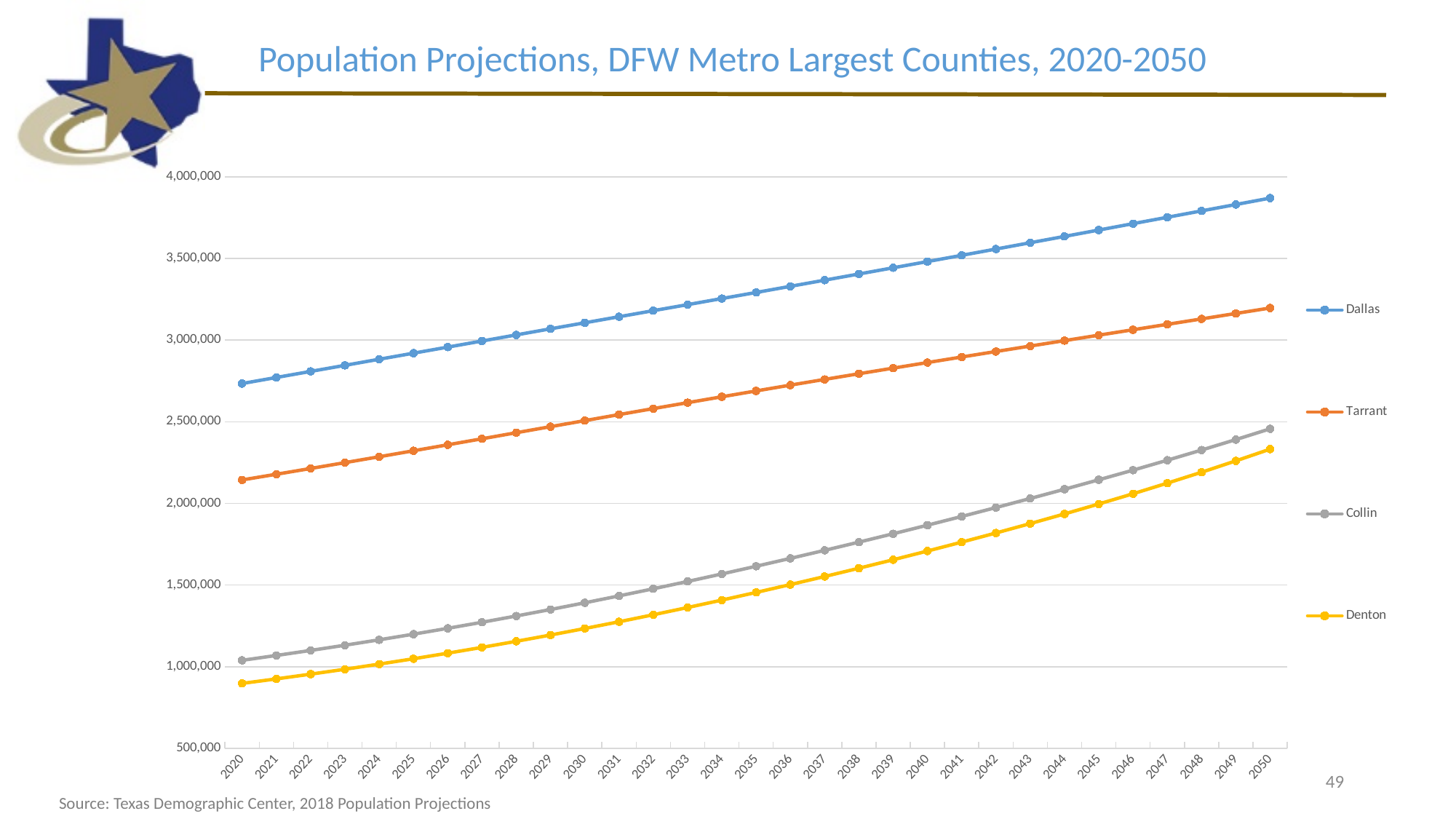
How many years are plotted along the x axis? 31 Which county has the lowest projected population in 2020? Denton What is the title of the chart? Population Projections, DFW Metro Largest Counties, 2020-2050 Is the value for Dallas in 2020 greater or less than 2,500,000? greater Is the value for Denton in 2020 greater or less than 1,000,000? less Is the value for Tarrant in 2050 greater or less than 3,000,000? greater In 2050, which county has the larger projected population, Collin or Denton? Collin Which county has the highest projected population in 2050? Dallas What kind of chart is shown on the slide? line chart Does the projected population for Dallas rise or fall from 2020 to 2050? rise How many series does the legend list? 4